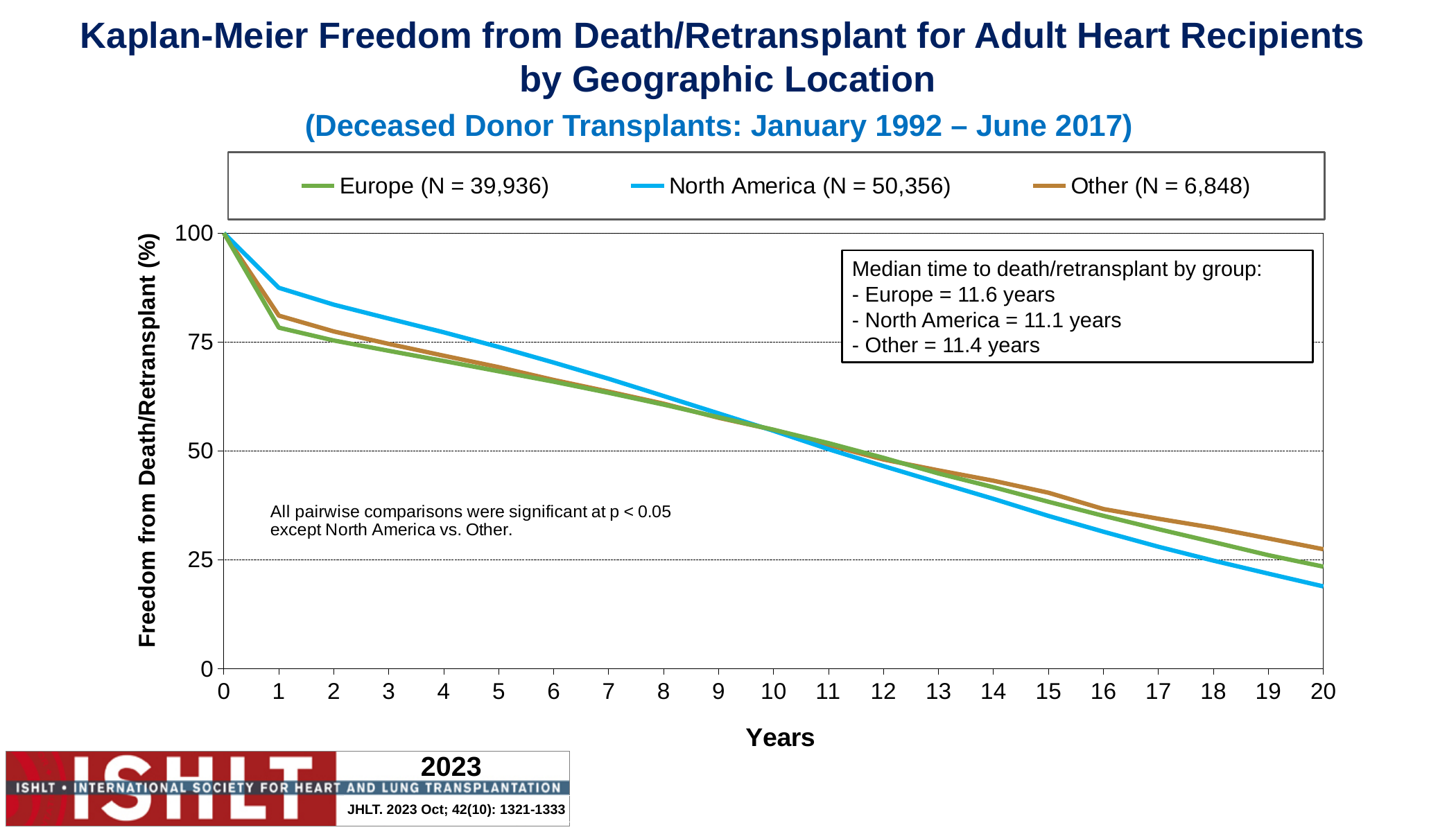
How many series does the legend list? 3 What is the median time to death/retransplant for North America? 11.1 years What is the median time to death/retransplant for Europe? 11.6 years What is the median time to death/retransplant for Other? 11.4 years Which group has the lowest freedom from death/retransplant at year 20? North America Which group has the highest freedom from death/retransplant at year 20? Other What is the N for the Europe group shown in the legend? 39,936 What kind of chart is shown on the slide? Line chart Is the value for North America at year 10 greater or less than 50? greater Is the value for North America at year 20 greater or less than 25? less What is the freedom from death/retransplant value for all three groups at year 0? 100 Do the values for all three groups rise or fall as the years increase? Fall